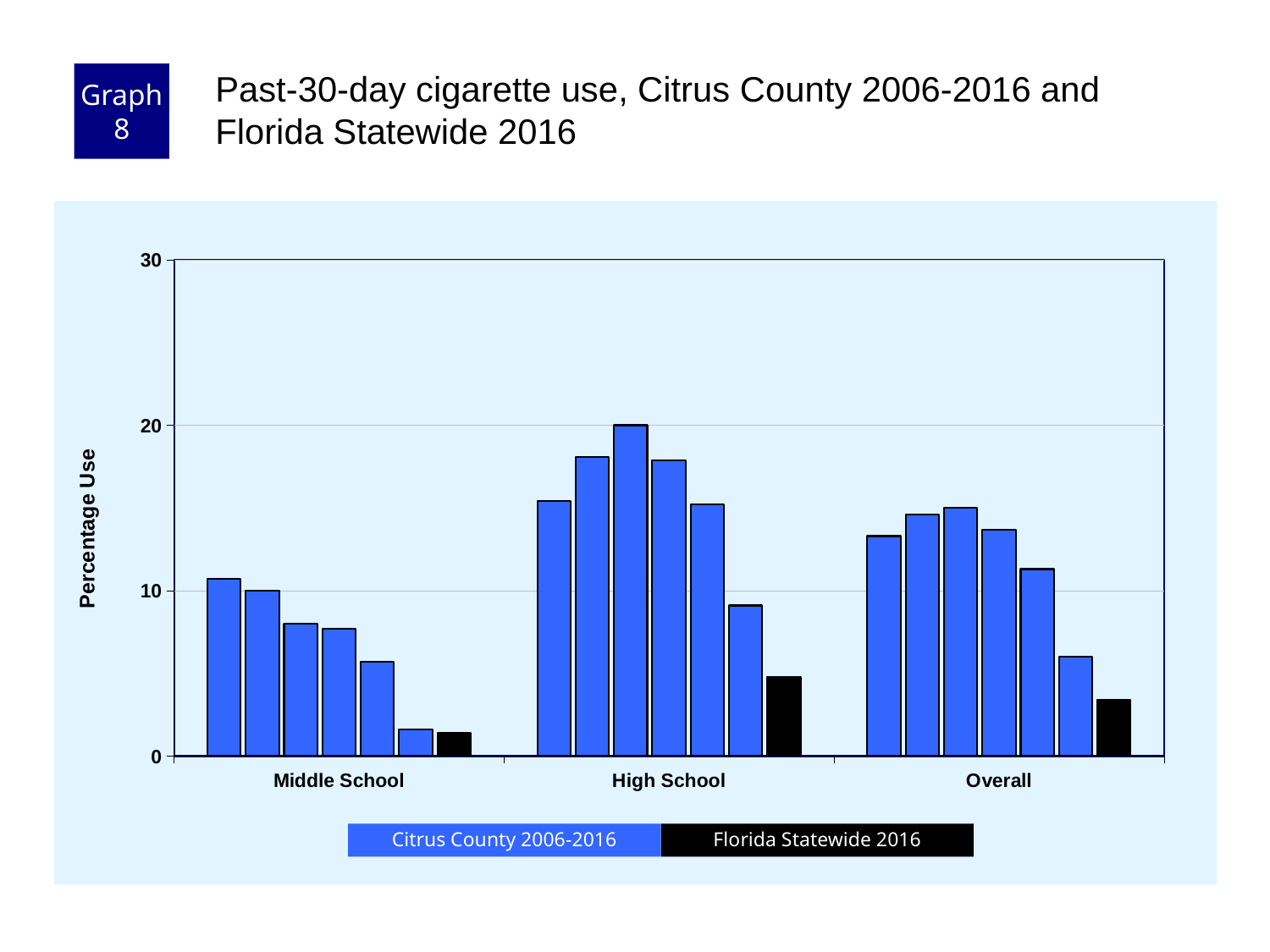
What kind of chart is shown on the slide? bar chart Which category has the highest Florida Statewide 2016 value? High School Which category has the lowest Florida Statewide 2016 value? Middle School What colour represents Florida Statewide 2016 in the legend? black Is the tallest Citrus County 2006-2016 bar in the High School group greater or less than 10? greater How many categories are shown along the x axis? 3 In the Middle School group, do the Citrus County 2006-2016 bars rise or fall from left to right? fall Is the Florida Statewide 2016 value for High School greater or less than 10? less What is the label on the y axis? Percentage Use Which is larger, the Florida Statewide 2016 value for High School or for Overall? High School Is the Florida Statewide 2016 value for Overall greater or less than 10? less How many series does the legend list? 2